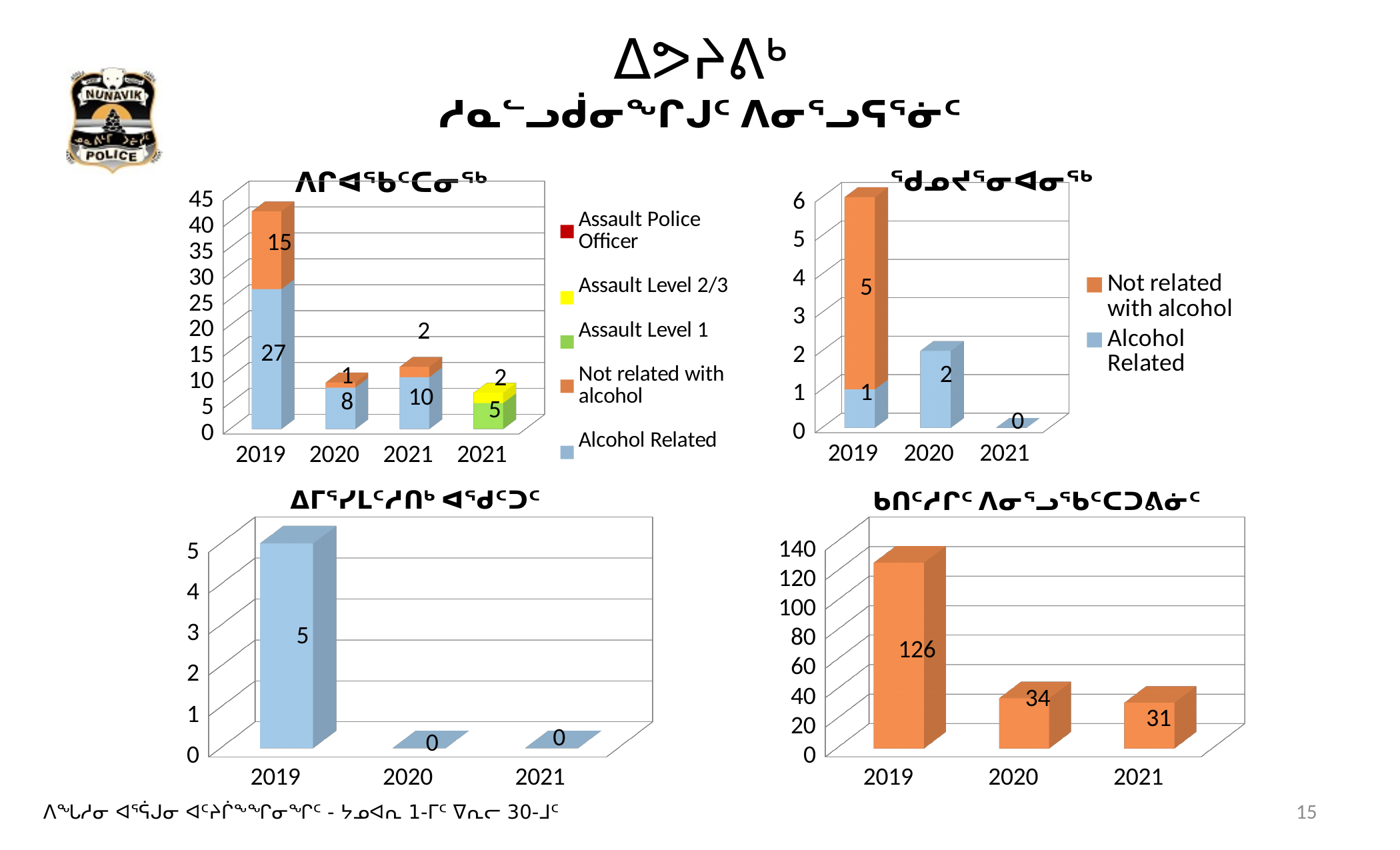
In the bottom-right chart, what is the difference between the values for 2020 and 2021? 3 In the top-left chart, what is the Not related with alcohol value for 2019? 15 In the top-right chart, what is the total of the stacked bar for 2019? 6 How many series does the legend of the top-left chart list? 5 In the top-left chart, what is the total of the stacked bar for 2020? 9 In the top-left chart, what is the Alcohol Related value for 2019? 27 In the bottom-right chart, what is the value for 2019? 126 In the top-right chart, which year has the lowest total? 2021 In the bottom-right chart, do the values rise or fall from 2019 to 2021? fall In the bottom-left chart, what is the value for 2019? 5 In the top-right chart, what is the Not related with alcohol value for 2019? 5 In the top-left chart, what is the total of the stacked bar for 2019? 42